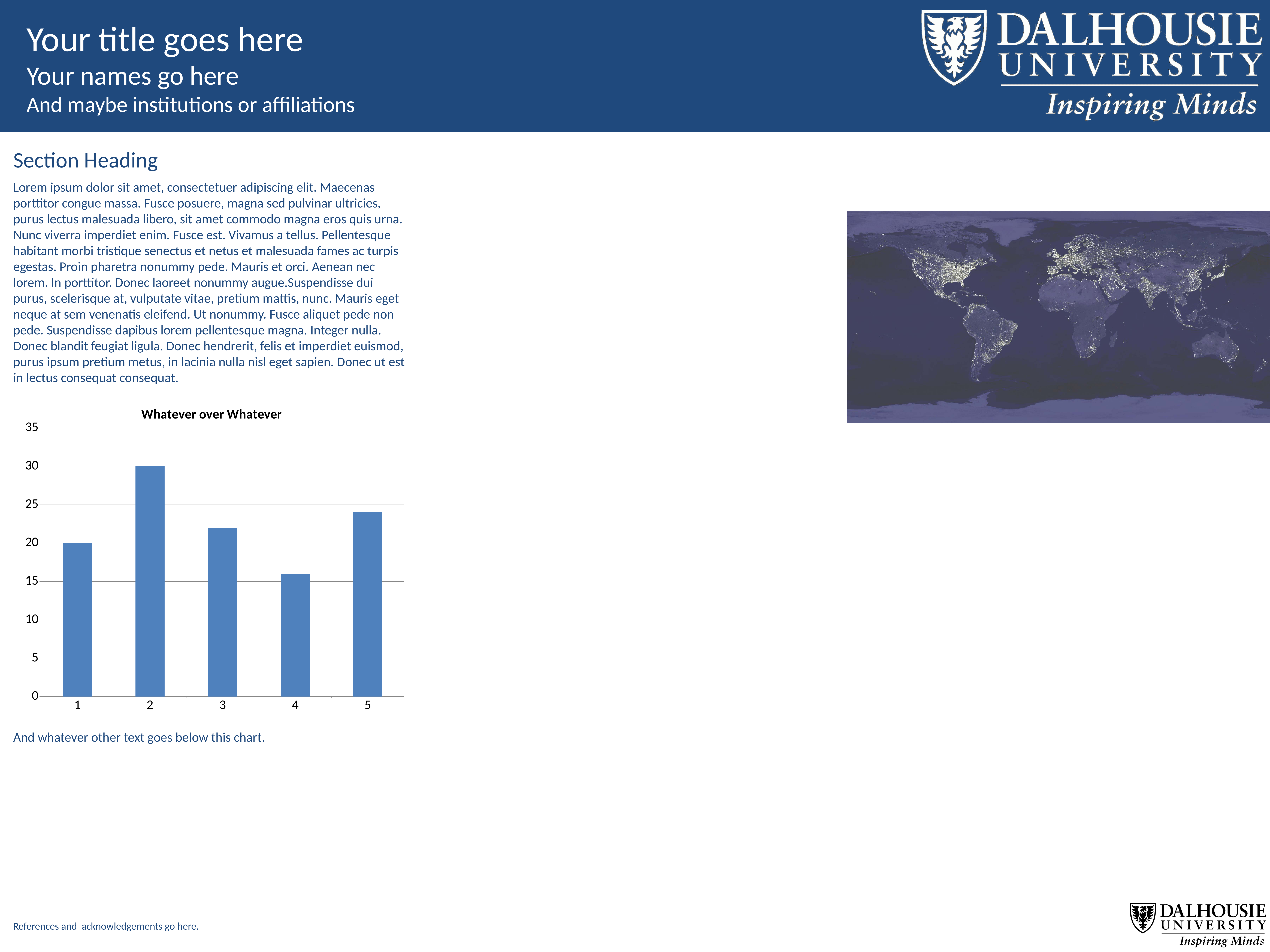
What is the value for category 2? 30 What is the difference between the values for category 2 and category 1? 10 Which category has the lowest value? 4 Is the value for category 4 greater or less than 20? less What is the value for category 1? 20 Is the value for category 3 greater or less than 20? greater How many categories are plotted in the chart? 5 Which category has the highest value? 2 What kind of chart is shown on the slide? bar chart What is the title of the chart? Whatever over Whatever Is the value for category 5 greater or less than 25? less Which has the larger value, category 5 or category 4? 5